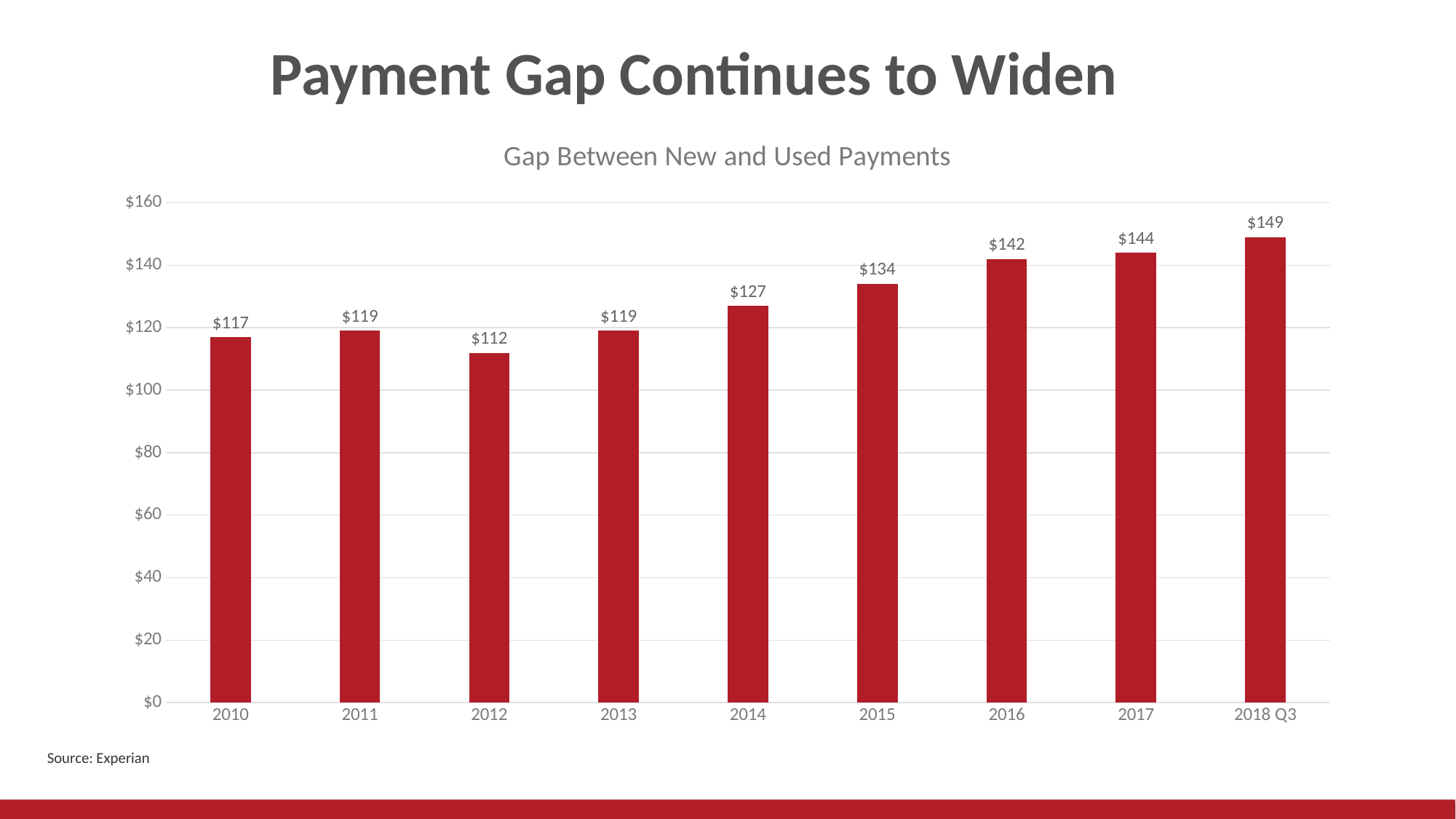
Which year has the lowest gap between new and used payments? 2012 What is the gap between new and used payments in 2014? $127 How many bars are shown in the chart? 9 Which year has the highest gap between new and used payments? 2018 Q3 What kind of chart is shown on the slide? Bar chart What is the difference between the 2018 Q3 value and the 2010 value? $32 What is the value shown for 2018 Q3? $149 What is the value shown for 2012? $112 What is the title of the chart? Gap Between New and Used Payments Is the value for 2017 greater or less than $140? greater Which is larger, the value for 2013 or the value for 2012? 2013 What is the difference between the 2016 value and the 2015 value? $8